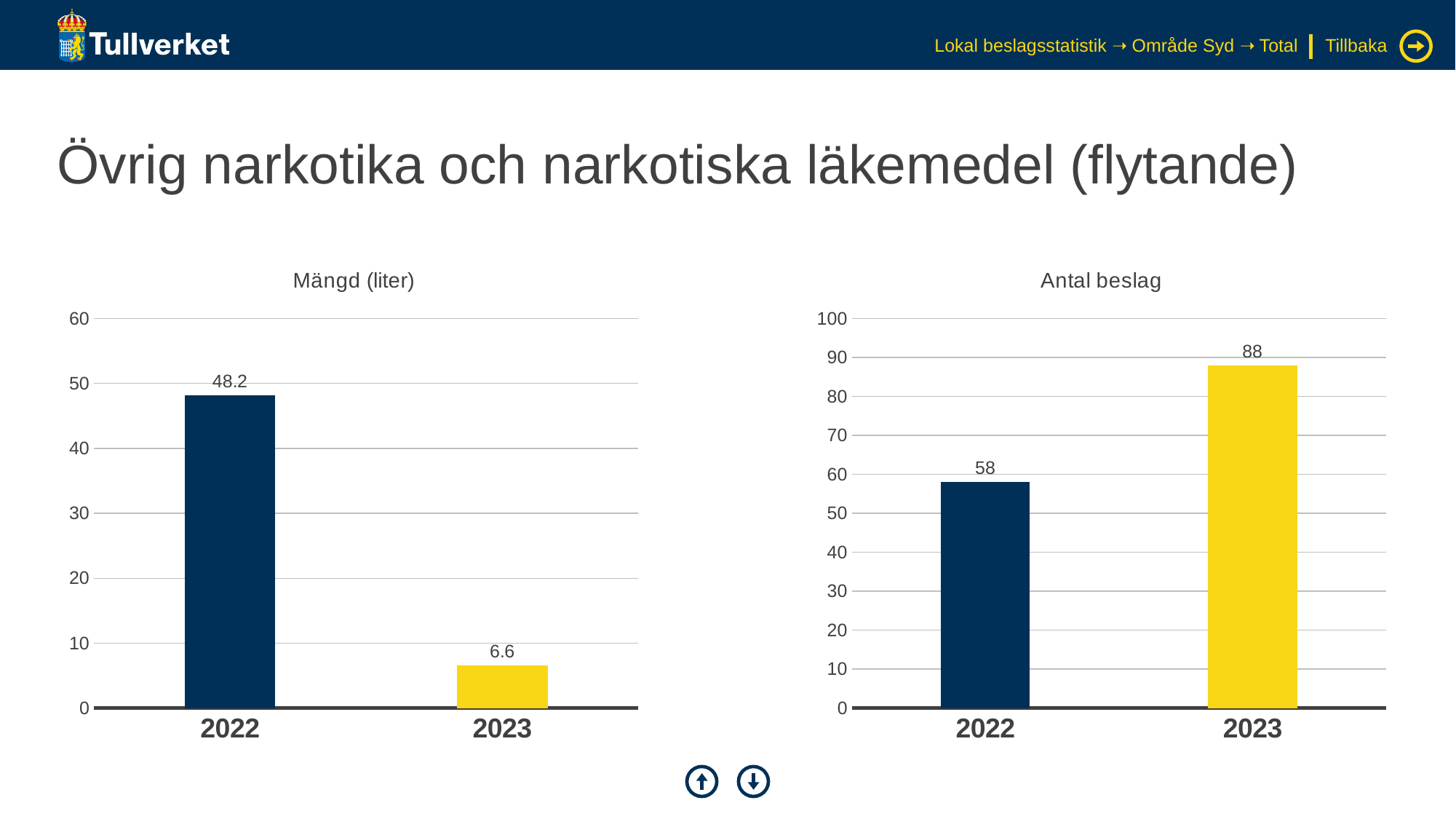
In the 'Mängd (liter)' chart, do the values rise or fall from 2022 to 2023? fall In the 'Antal beslag' chart, what is the difference between the 2023 and 2022 values? 30 How many bars are shown in the 'Antal beslag' chart? 2 In the 'Mängd (liter)' chart, which year has the highest value? 2022 In the 'Mängd (liter)' chart, what is the value for 2022? 48.2 In the 'Mängd (liter)' chart, what is the value for 2023? 6.6 In the 'Antal beslag' chart, is the value for 2023 greater or less than 80? greater In the 'Mängd (liter)' chart, what is the difference between the 2022 and 2023 values? 41.6 In the 'Antal beslag' chart, what is the value for 2023? 88 What type of chart is the 'Mängd (liter)' chart? bar chart In the 'Antal beslag' chart, what is the value for 2022? 58 In the 'Antal beslag' chart, which year has the lowest value? 2022